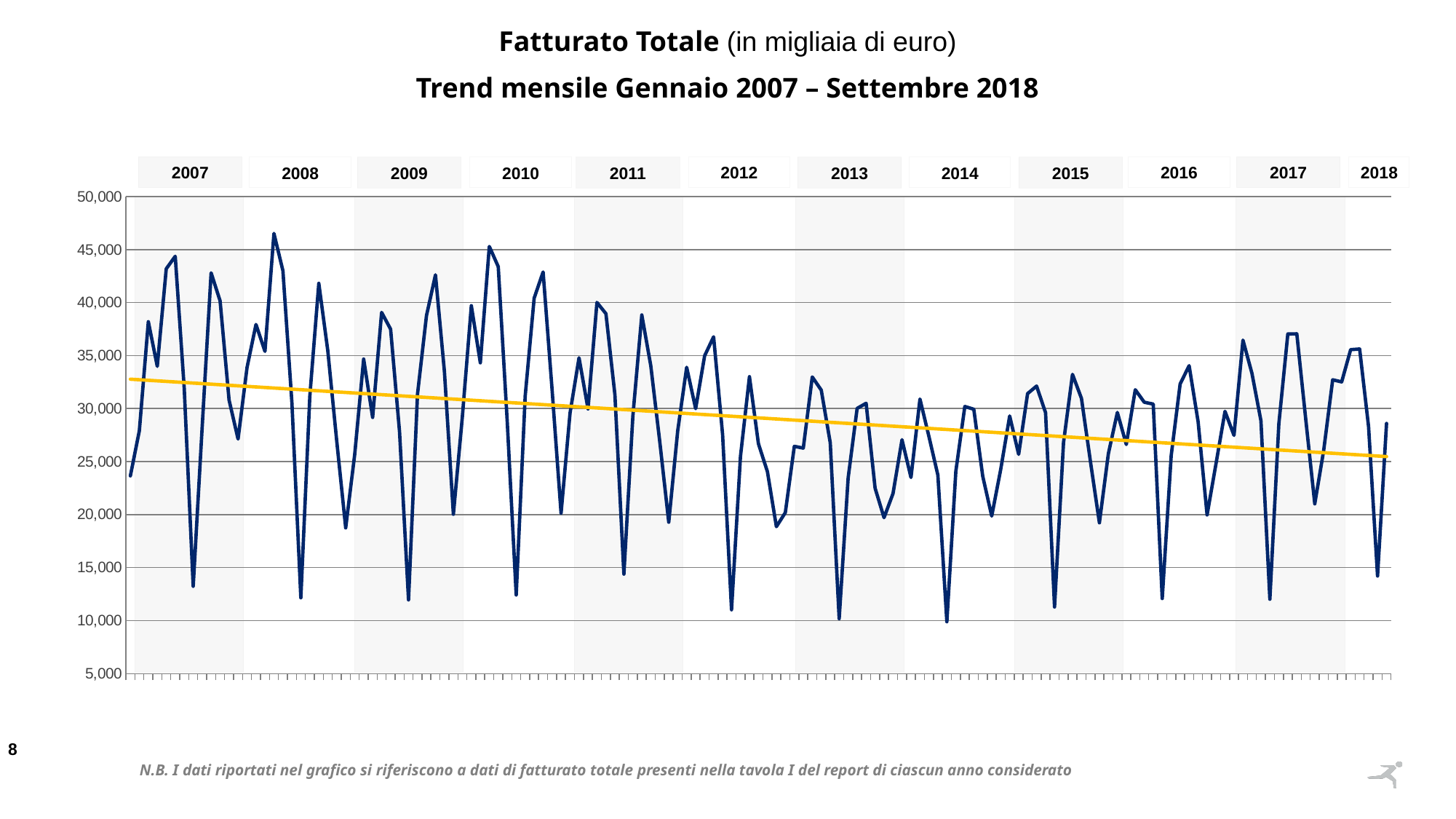
Is the highest peak in 2017 greater or less than 35,000? greater What is the highest value shown on the vertical axis? 50,000 What kind of chart is shown on the slide? line chart Is the value of the yellow trend line at the end of 2018 greater or less than 30,000? less In what unit are the values expressed, according to the chart title? migliaia di euro According to the yellow trend line, do the values rise or fall from 2007 to 2018? fall How many years are labelled along the top of the chart? 12 Is the value of the yellow trend line at the start of 2007 greater or less than 30,000? greater In which year does the line reach its highest peak? 2008